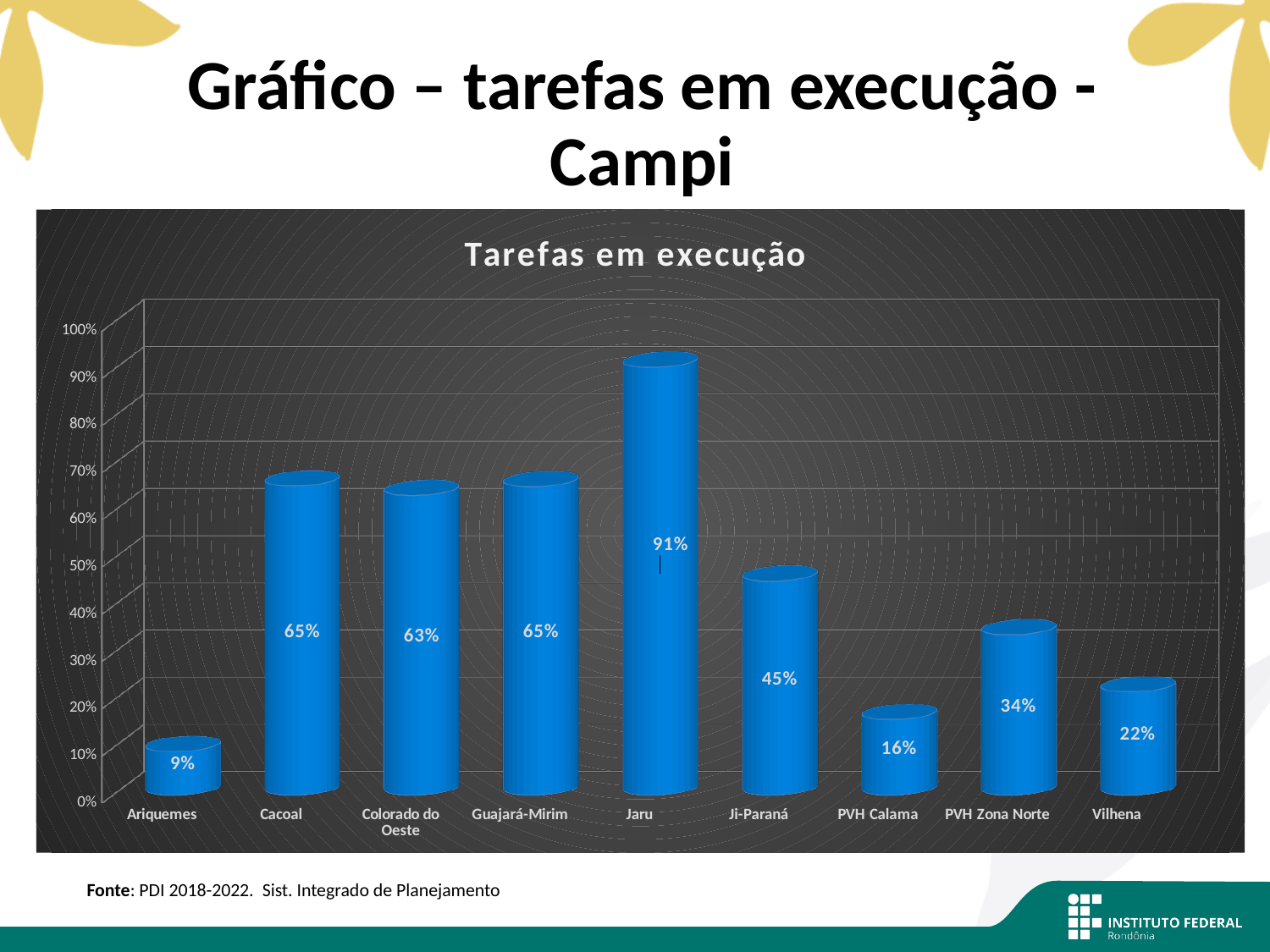
Is the value for Ji-Paraná greater or less than 50%? less What is the value for Ariquemes? 9% What is the title of the chart? Tarefas em execução Which campus has the highest value? Jaru What is the value for PVH Zona Norte? 34% Which campus has the lowest value? Ariquemes What is the value for Jaru? 91% What is the difference between the values for Vilhena and PVH Calama? 6% What kind of chart is shown on the slide? bar chart How many campi are shown on the chart? 9 Which is larger, the value for Cacoal or the value for Colorado do Oeste? Cacoal What is the difference between the values for Jaru and Ji-Paraná? 46%